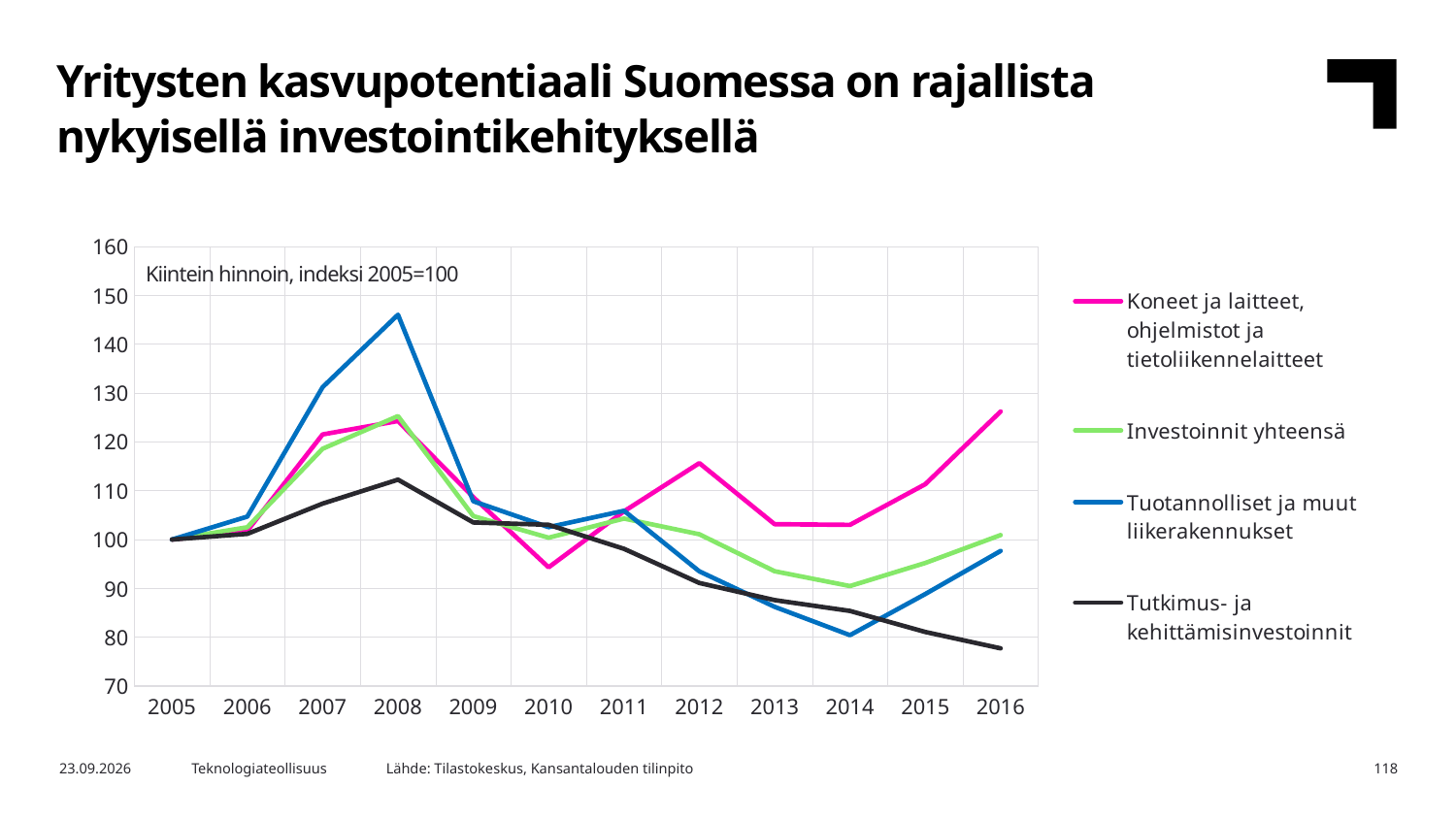
Is the value for Koneet ja laitteet, ohjelmistot ja tietoliikennelaitteet in 2016 greater or less than 120? greater How many series does the legend list? 4 What note is printed inside the chart area about the price basis and index? Kiintein hinnoin, indeksi 2005=100 Is the value for Tutkimus- ja kehittämisinvestoinnit in 2016 greater or less than 90? less Which series has the highest value in 2008? Tuotannolliset ja muut liikerakennukset Is the value for Tuotannolliset ja muut liikerakennukset in 2008 greater or less than 140? greater Which series has the lowest value in 2016? Tutkimus- ja kehittämisinvestoinnit In 2012, which is higher: Koneet ja laitteet, ohjelmistot ja tietoliikennelaitteet or Tuotannolliset ja muut liikerakennukset? Koneet ja laitteet, ohjelmistot ja tietoliikennelaitteet How many years are shown on the x axis? 12 Does the Tutkimus- ja kehittämisinvestoinnit line rise or fall from 2008 to 2016? Fall What is the value of Investoinnit yhteensä in 2005? 100 What type of chart is shown on the slide? Line chart